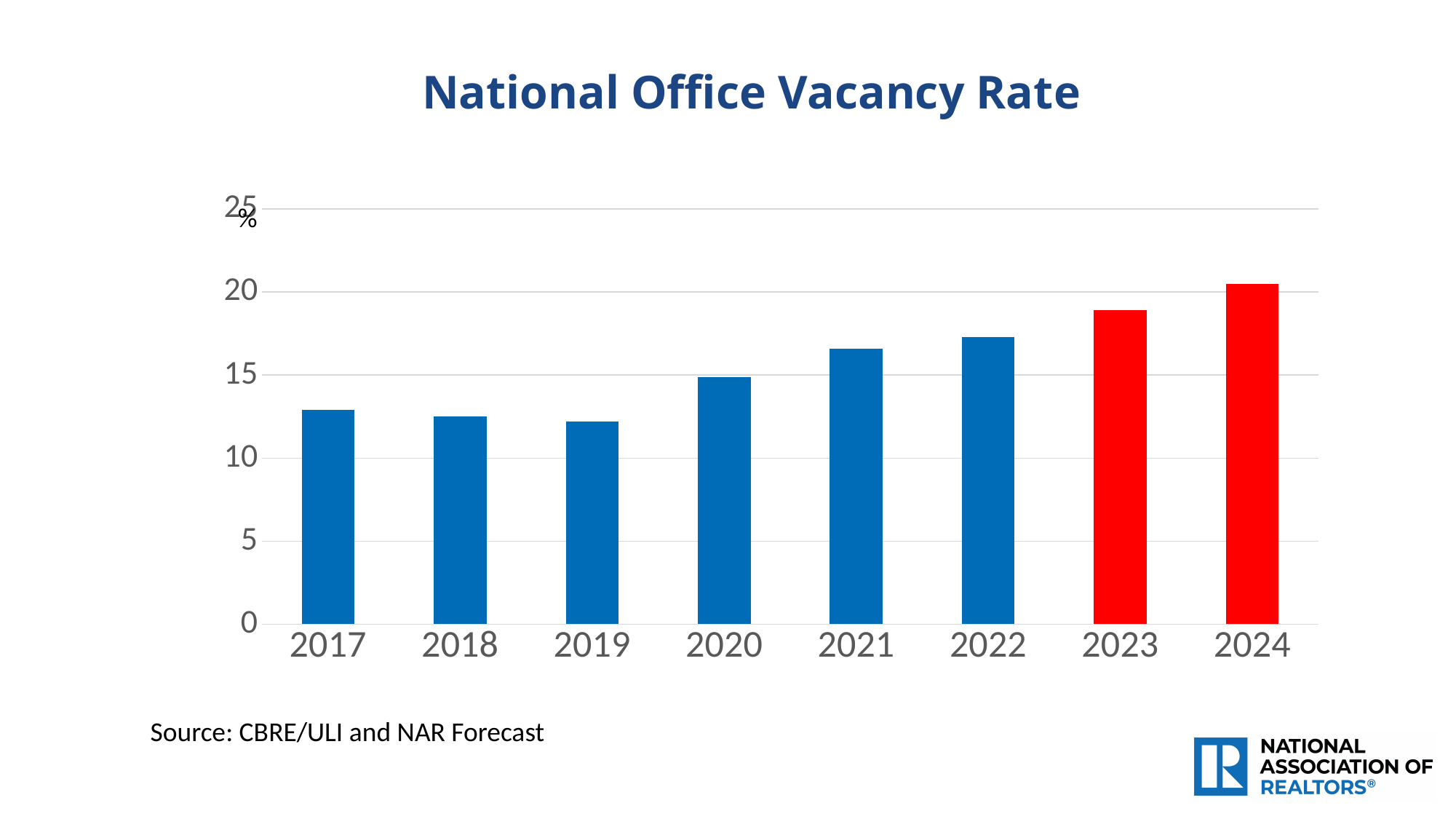
Is the value for 2022 greater or less than 20? less Is the value for 2023 greater or less than 20? less What is the title of the chart? National Office Vacancy Rate Is the value for 2021 greater or less than 15? greater How many years are shown on the x axis of the chart? 8 What kind of chart is shown on the slide? bar chart From 2019 to 2024, do the values rise or fall? rise What colour are the bars for 2023 and 2024? red Which is larger, the value for 2020 or the value for 2019? 2020 Which year has the highest national office vacancy rate? 2024